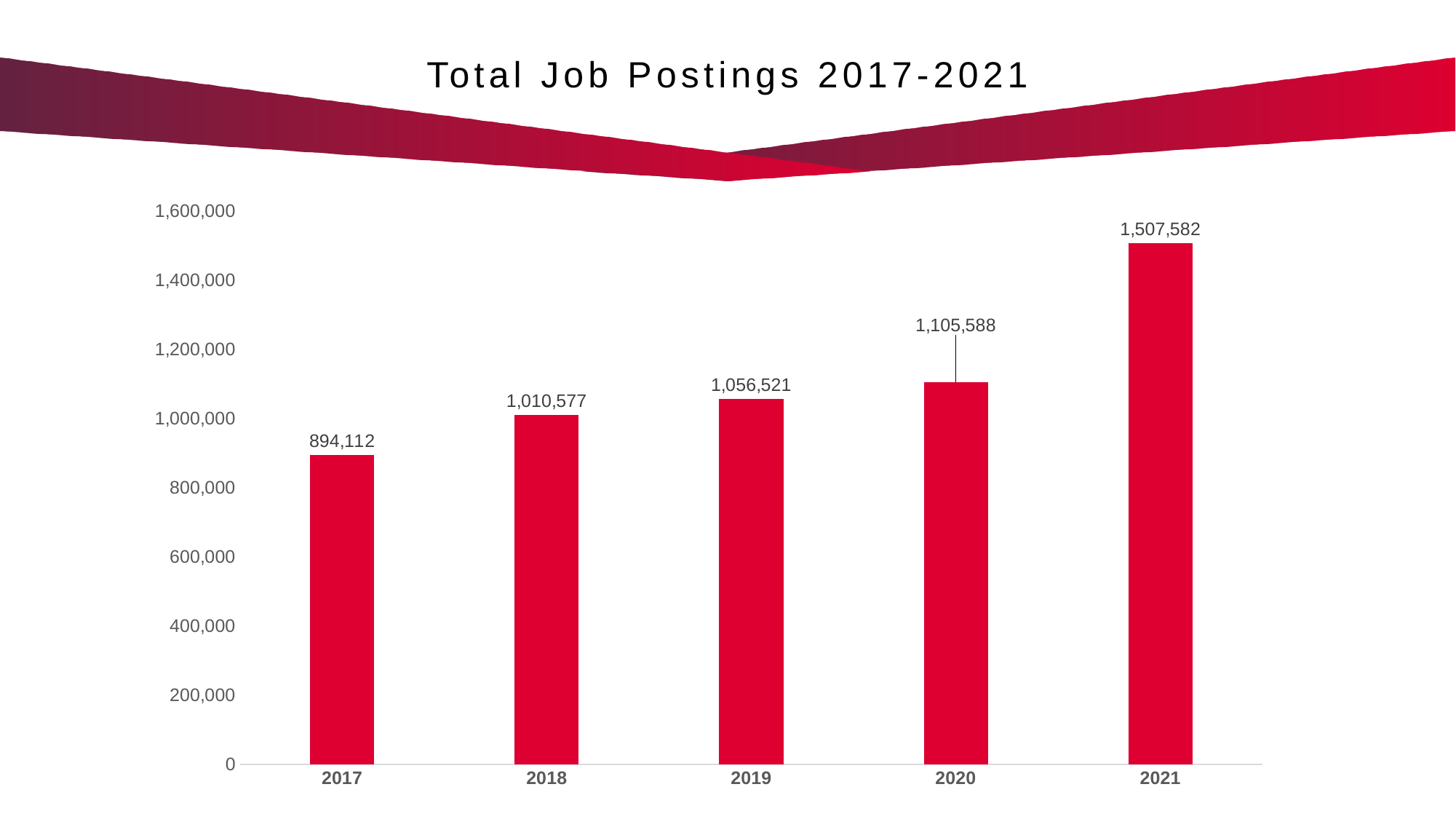
Do job postings rise or fall from 2017 to 2021? rise What is the difference in job postings between 2018 and 2017? 116,465 How many years are shown on the chart? 5 Which year has the highest number of job postings? 2021 What is the total number of job postings in 2017? 894,112 What is the total number of job postings in 2019? 1,056,521 What kind of chart is shown on the slide? bar chart Which year had more job postings, 2018 or 2020? 2020 What is the total number of job postings in 2021? 1,507,582 Which year has the lowest number of job postings? 2017 Is the value for 2017 greater or less than 1,000,000? less What is the difference in job postings between 2021 and 2020? 401,994